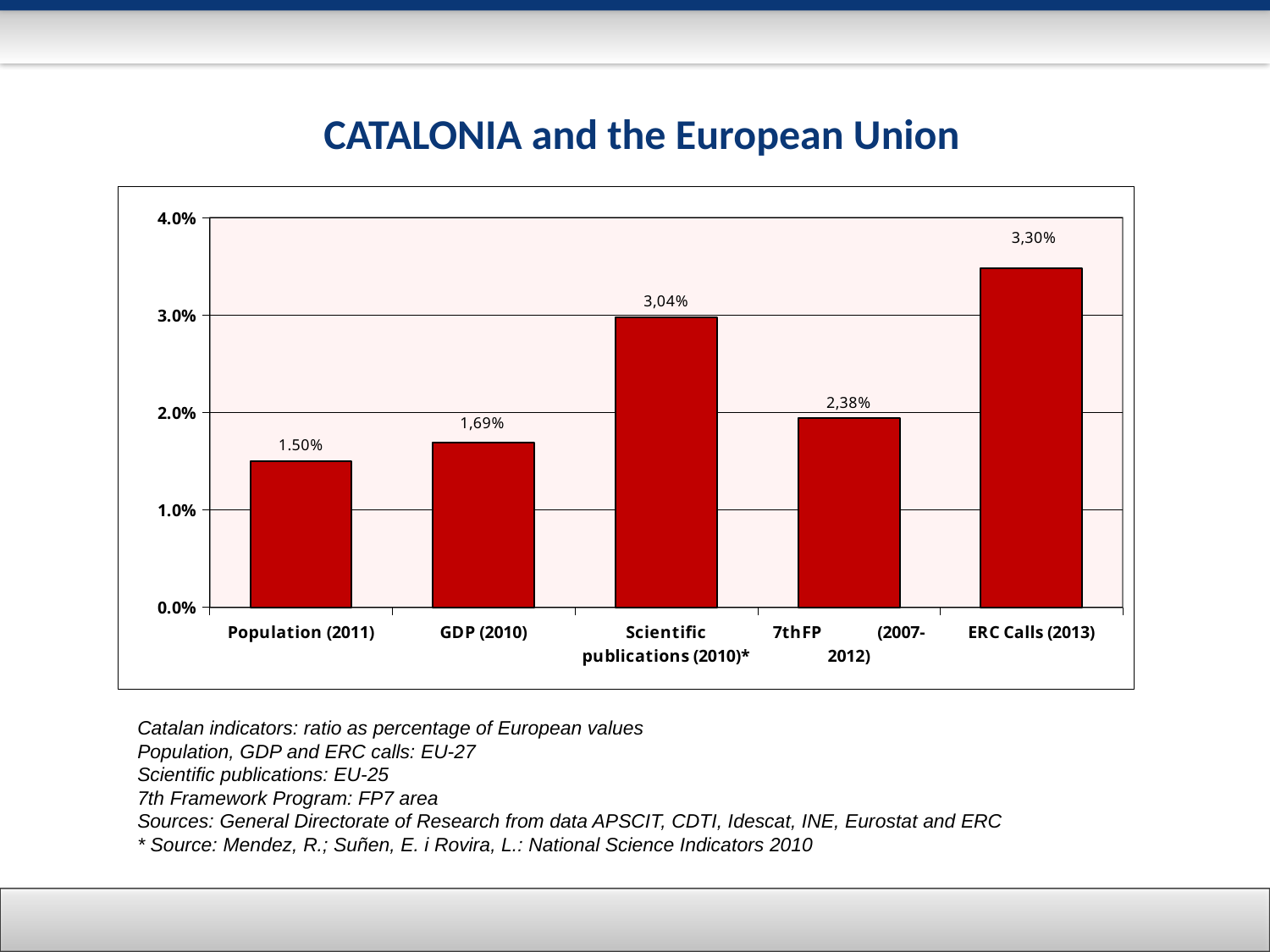
What is the value shown for Scientific publications (2010)*? 3,04% What is the value shown for 7thFP (2007-2012)? 2,38% Is the value for GDP (2010) greater or less than 2.0%? less Which category has the highest value? ERC Calls (2013) Which is larger, the value for Scientific publications (2010)* or the value for 7thFP (2007-2012)? Scientific publications (2010)* What is the value shown for GDP (2010)? 1,69% What kind of chart is shown on the slide? bar chart How many categories are shown on the x axis? 5 What is the title of the slide above the chart? CATALONIA and the European Union What is the value shown for ERC Calls (2013)? 3,30% Which category has the lowest value? Population (2011) What is the value shown for Population (2011)? 1.50%